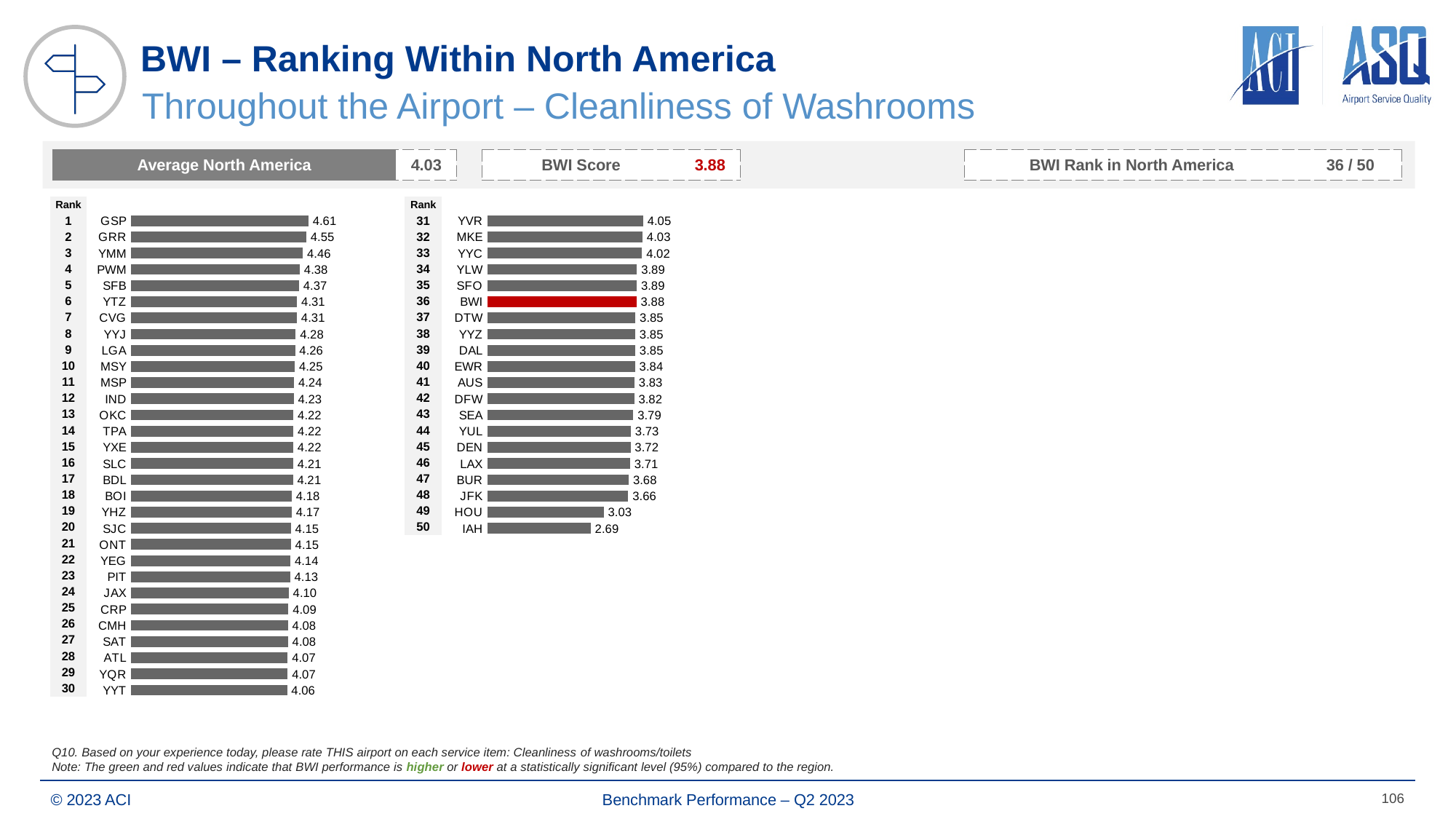
In the right chart (ranks 31–50), which airport has the lowest value? IAH What kind of chart is used to show the airport rankings on this slide? Bar chart In the left chart (ranks 1–30), what is the value for GSP? 4.61 In the right chart (ranks 31–50), what is the difference between the value for HOU and the value for IAH? 0.34 In the right chart (ranks 31–50), which is larger, the value for YVR or the value for JFK? YVR In the right chart (ranks 31–50), which airport's bar is coloured red? BWI In the right chart (ranks 31–50), what is the value for IAH? 2.69 In the right chart (ranks 31–50), what is the value for BWI? 3.88 What is the difference between the value for GSP and the value for YYT in the left chart (ranks 1–30)? 0.55 How many airports are plotted in the right chart (ranks 31–50)? 20 In the left chart (ranks 1–30), which airport has the highest value? GSP How many airports are plotted in the left chart (ranks 1–30)? 30